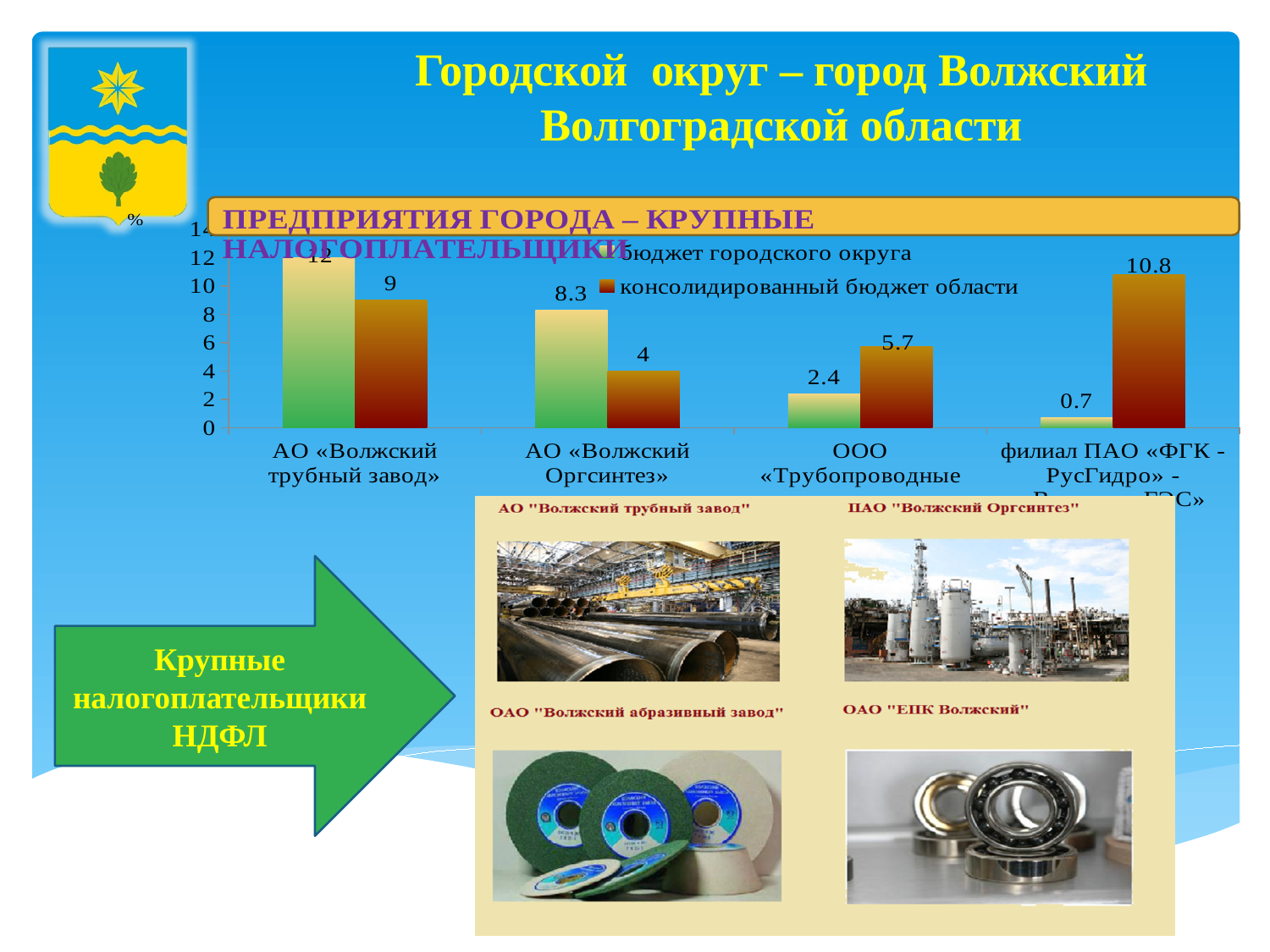
What is the value for ООО «Трубопроводные...» in the series «бюджет городского округа»? 2.4 What is the value for филиал ПАО «ФГК - РусГидро» in the series «консолидированный бюджет области»? 10.8 How many series does the chart legend list? 2 For ООО «Трубопроводные...», which series has the larger value: «бюджет городского округа» or «консолидированный бюджет области»? консолидированный бюджет области Which category has the lowest value in the series «бюджет городского округа»? филиал ПАО «ФГК - РусГидро» Which category has the lowest value in the series «консолидированный бюджет области»? АО «Волжский Оргсинтез» Which category has the highest value in the series «бюджет городского округа»? АО «Волжский трубный завод» What is the difference between the two series values for АО «Волжский Оргсинтез»? 4.3 What is the value for АО «Волжский Оргсинтез» in the series «консолидированный бюджет области»? 4 What is the value for АО «Волжский трубный завод» in the series «бюджет городского округа»? 12 How many categories are shown on the x axis of the chart? 4 What type of chart is shown on the slide? bar chart